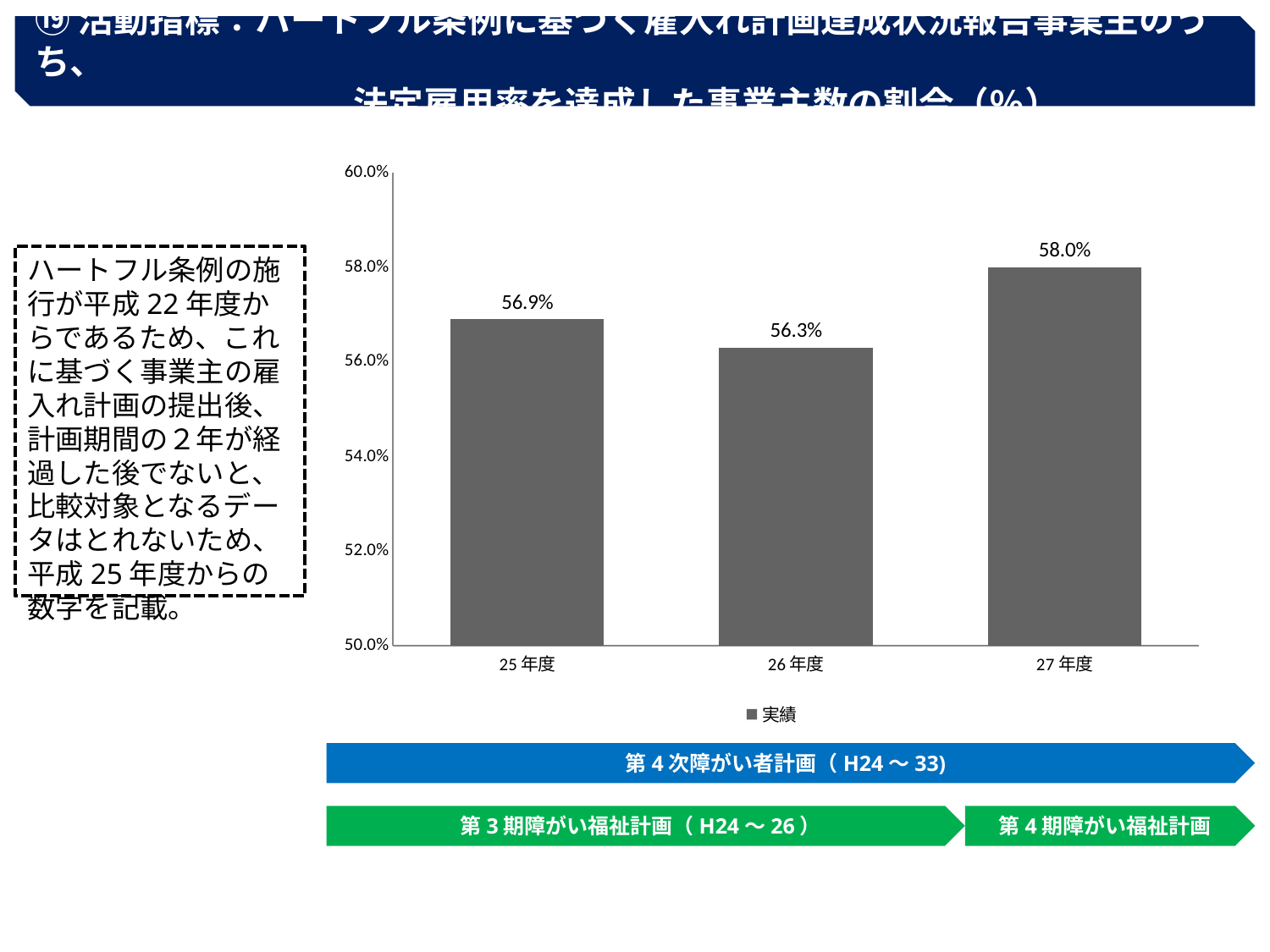
What series name does the legend show? 実績 What is the value for 27年度? 58.0% What is the difference between the values for 27年度 and 26年度? 1.7% What kind of chart is shown? bar chart Is the value for 26年度 greater or less than 58.0%? less How many years are shown on the x axis? 3 Which year has the lowest value? 26年度 What is the value for 26年度? 56.3% Which is larger, the value for 25年度 or the value for 27年度? 27年度 What is the difference between the values for 25年度 and 26年度? 0.6% Which year has the highest value? 27年度 What is the value for 25年度? 56.9%